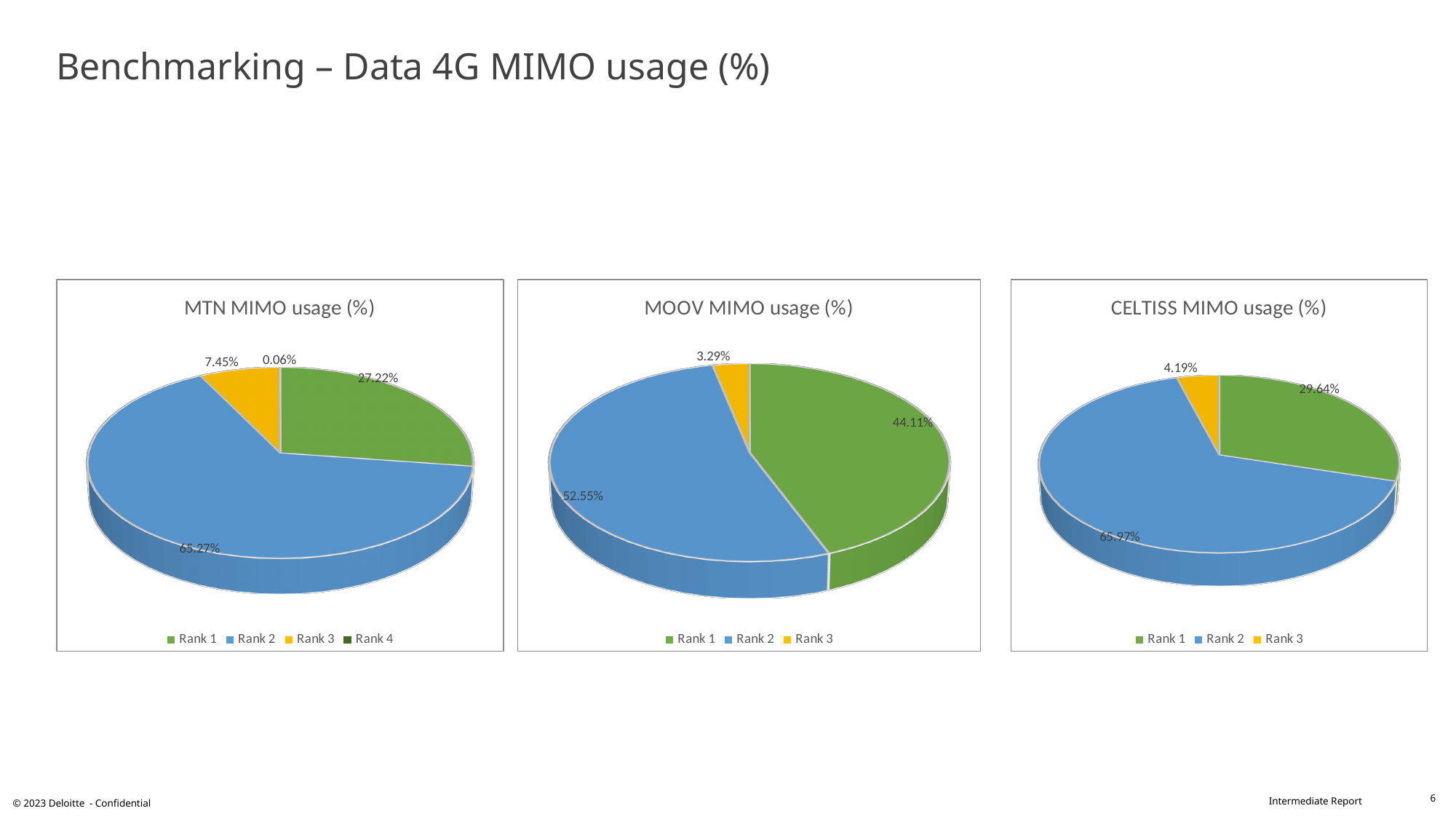
In the CELTISS MIMO usage (%) chart, what colour is the Rank 2 slice? Blue In the MTN MIMO usage (%) chart, what is the value for Rank 4? 0.06% In the MTN MIMO usage (%) chart, what is the value for Rank 2? 65.27% In the MOOV MIMO usage (%) chart, what is the value for Rank 1? 44.11% In the CELTISS MIMO usage (%) chart, what is the value for Rank 3? 4.19% In the CELTISS MIMO usage (%) chart, which rank has the smallest share? Rank 3 In the MOOV MIMO usage (%) chart, which is larger, Rank 1 or Rank 2? Rank 2 How many slices are labelled in the CELTISS MIMO usage (%) chart? 3 In the MTN MIMO usage (%) chart, what is the difference between the Rank 2 and Rank 1 values? 38.05% In the MOOV MIMO usage (%) chart, which rank has the largest share? Rank 2 How many entries does the legend of the MTN MIMO usage (%) chart list? 4 What kind of chart is the MOOV MIMO usage (%) chart? Pie chart